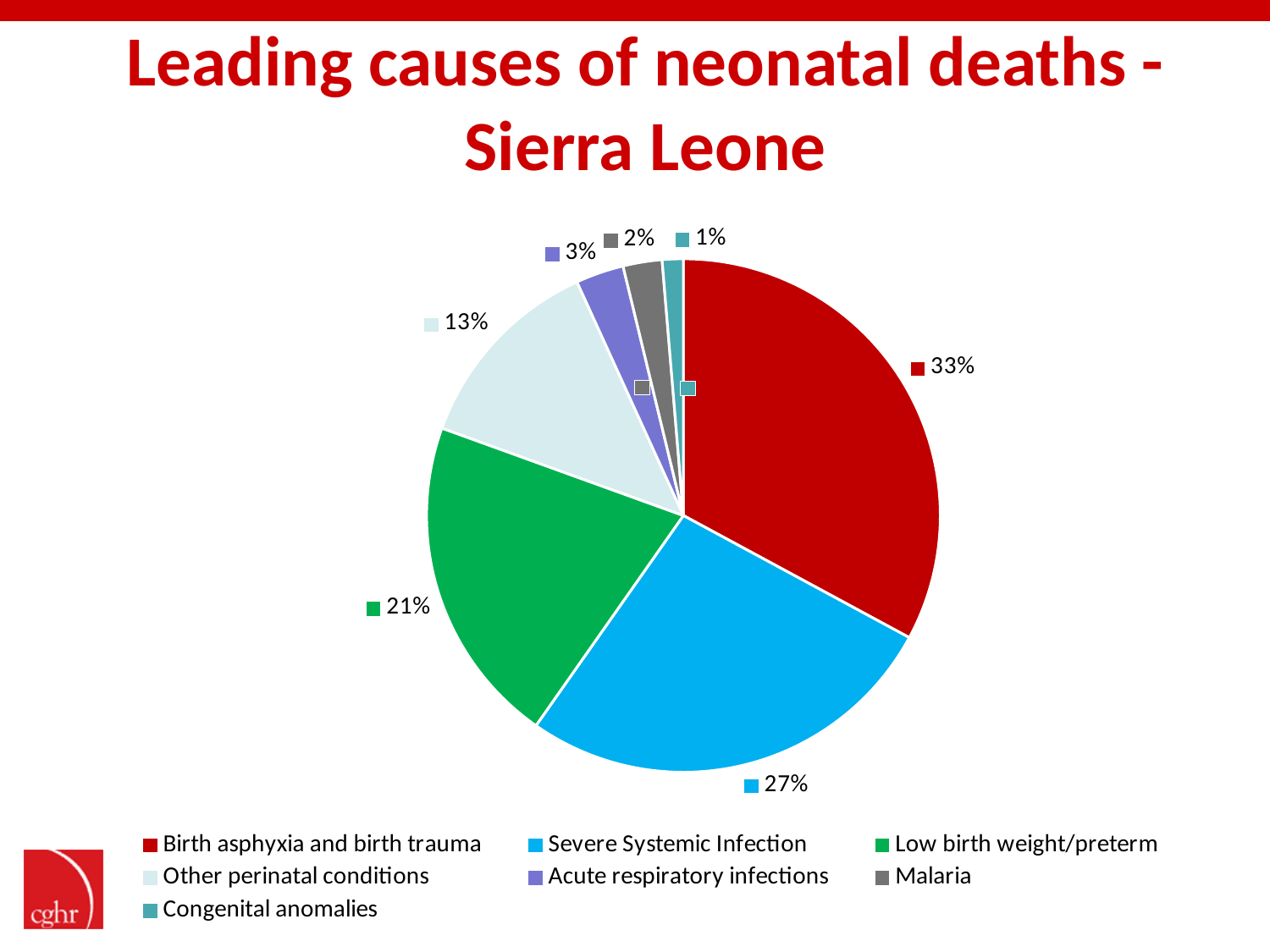
Which cause accounts for the largest share of neonatal deaths? Birth asphyxia and birth trauma What share of neonatal deaths is attributed to Low birth weight/preterm? 21% What is the title of the chart on the slide? Leading causes of neonatal deaths - Sierra Leone What share of neonatal deaths is attributed to Birth asphyxia and birth trauma? 33% What kind of chart is shown on the slide? Pie chart Which cause accounts for the smallest share of neonatal deaths? Congenital anomalies What share of neonatal deaths is attributed to Other perinatal conditions? 13% How many causes (slices) are shown in the pie chart? 7 How many percentage points larger is the share for Birth asphyxia and birth trauma than for Severe Systemic Infection? 6 Which has the larger share: Low birth weight/preterm or Other perinatal conditions? Low birth weight/preterm